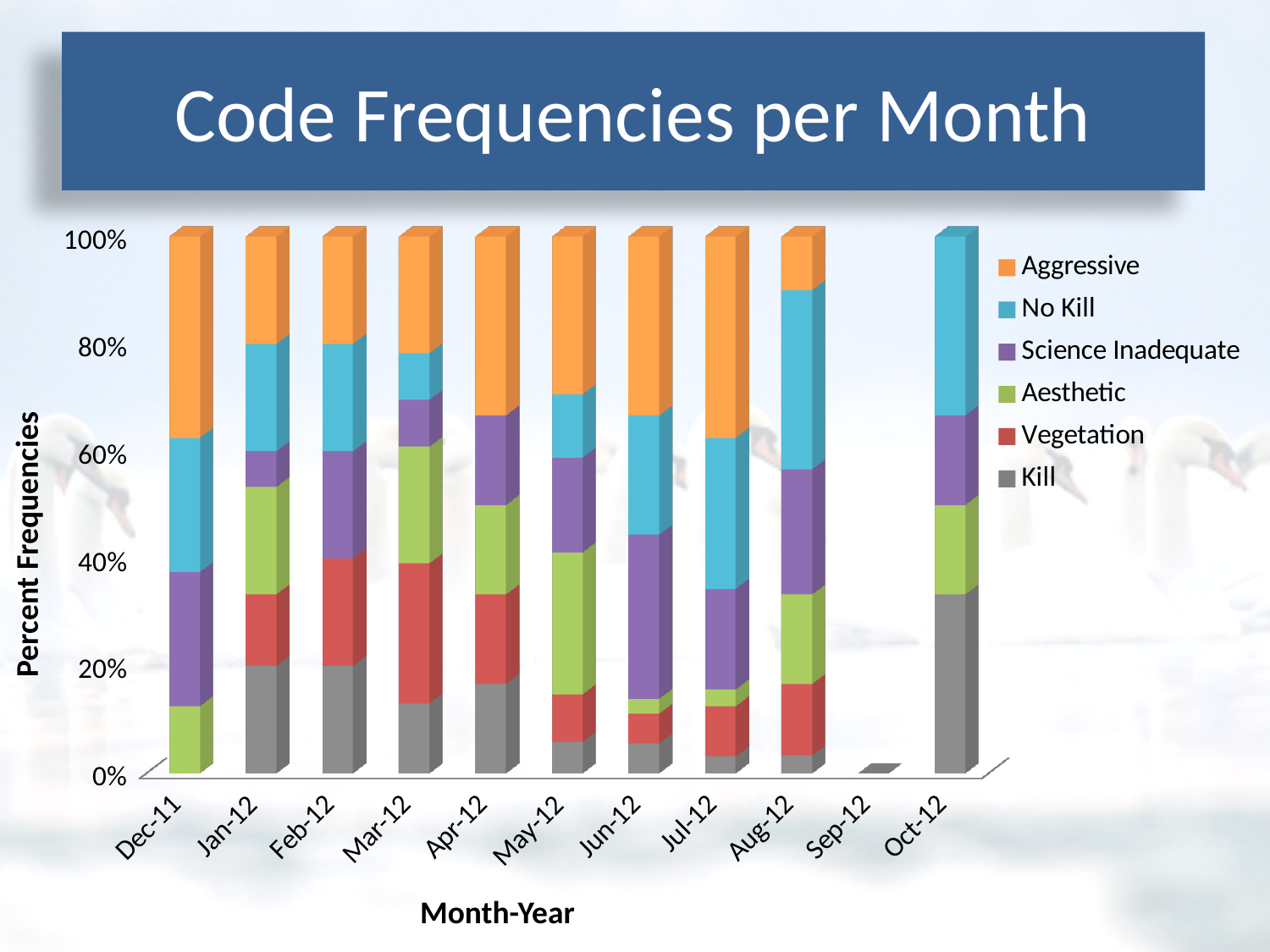
Which is larger, the Kill share for Oct-12 or the Kill share for Jul-12? Oct-12 Which month has the largest Vegetation share of its bar? Mar-12 What is the title of the chart? Code Frequencies per Month Is the Aggressive share for Dec-11 greater or less than 20%? greater What is the label on the vertical axis? Percent Frequencies How many months are shown on the x axis of the chart? 11 Is the Kill share for Oct-12 greater or less than 40%? less How many series does the legend list? 6 What kind of chart is shown on the slide? Stacked bar chart Which month has the largest Science Inadequate share of its bar? Jun-12 Which month has the largest Kill share of its bar? Oct-12 Is the Kill share for Oct-12 greater or less than 20%? greater